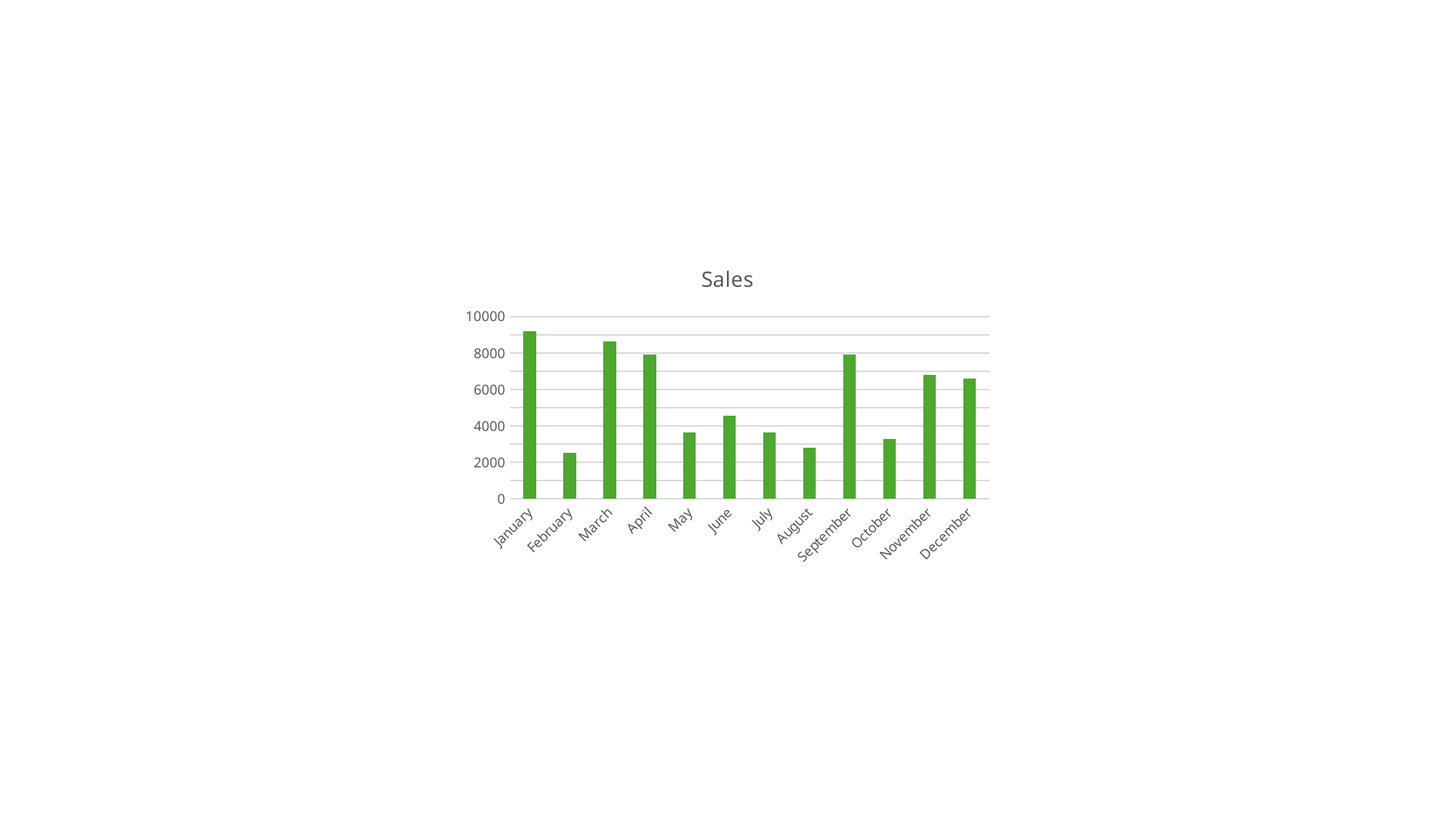
Is the value for June greater or less than 4000? greater Which month has the lowest sales value? February Which month has the highest sales value? January Is the value for November greater or less than 6000? greater Which month has higher sales, March or April? March What colour are the bars in the Sales chart? green Is the value for February greater or less than 4000? less How many months are shown on the x axis of the Sales chart? 12 What is the title of the chart? Sales Which month has higher sales, June or August? June What type of chart is shown on the slide? bar chart